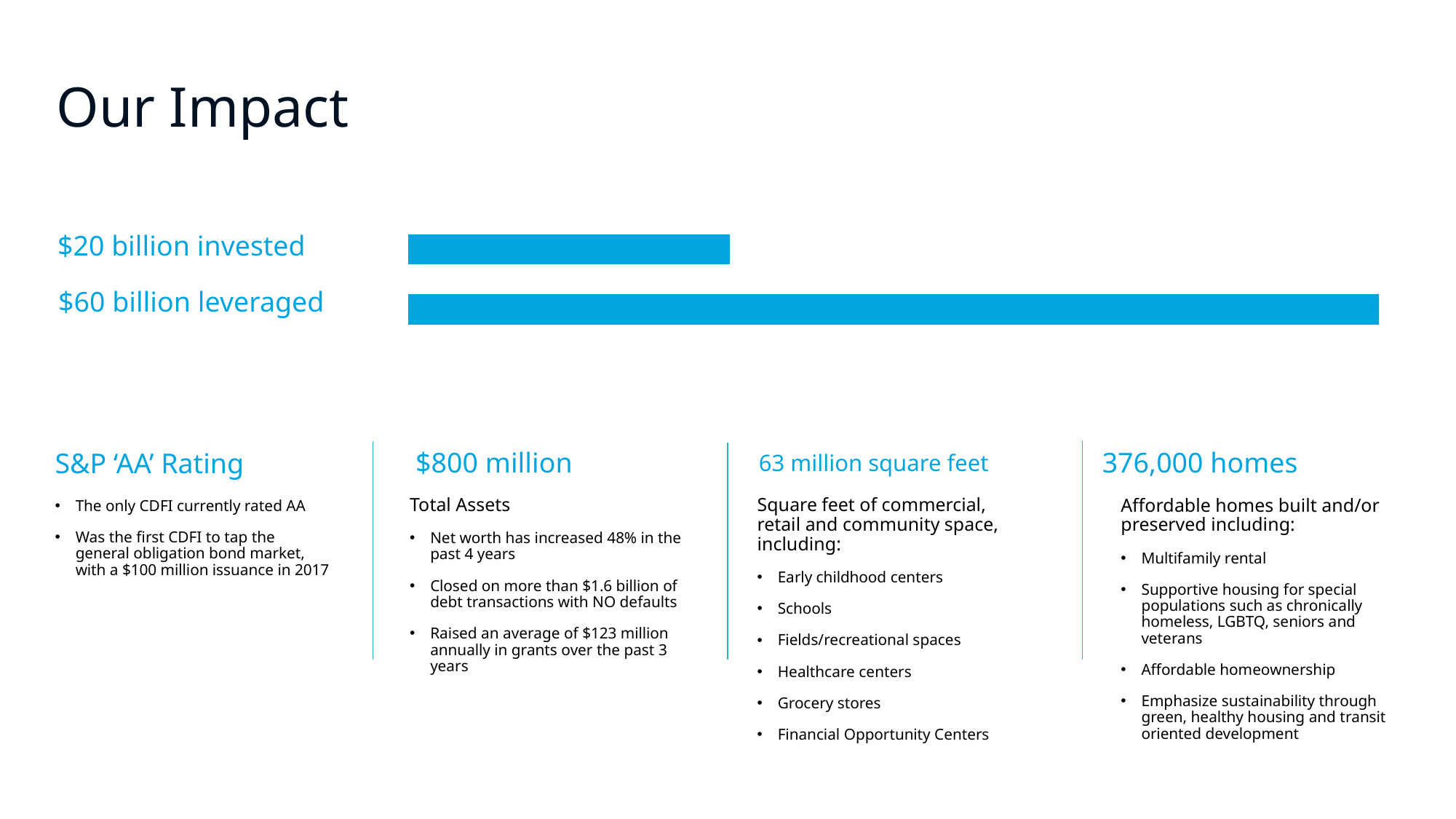
What value is shown for the 'invested' bar? $20 billion What value is shown for the 'leveraged' bar? $60 billion Is the amount invested larger or smaller than the amount leveraged? smaller What kind of chart is shown on the slide? bar chart Which bar represents the smaller amount, invested or leveraged? invested What is the difference between the amount leveraged and the amount invested? $40 billion How many bars are shown in the chart? 2 What colour are the bars in the chart? blue Which bar represents the larger amount, invested or leveraged? leveraged Are the bars in the chart drawn horizontally or vertically? horizontally